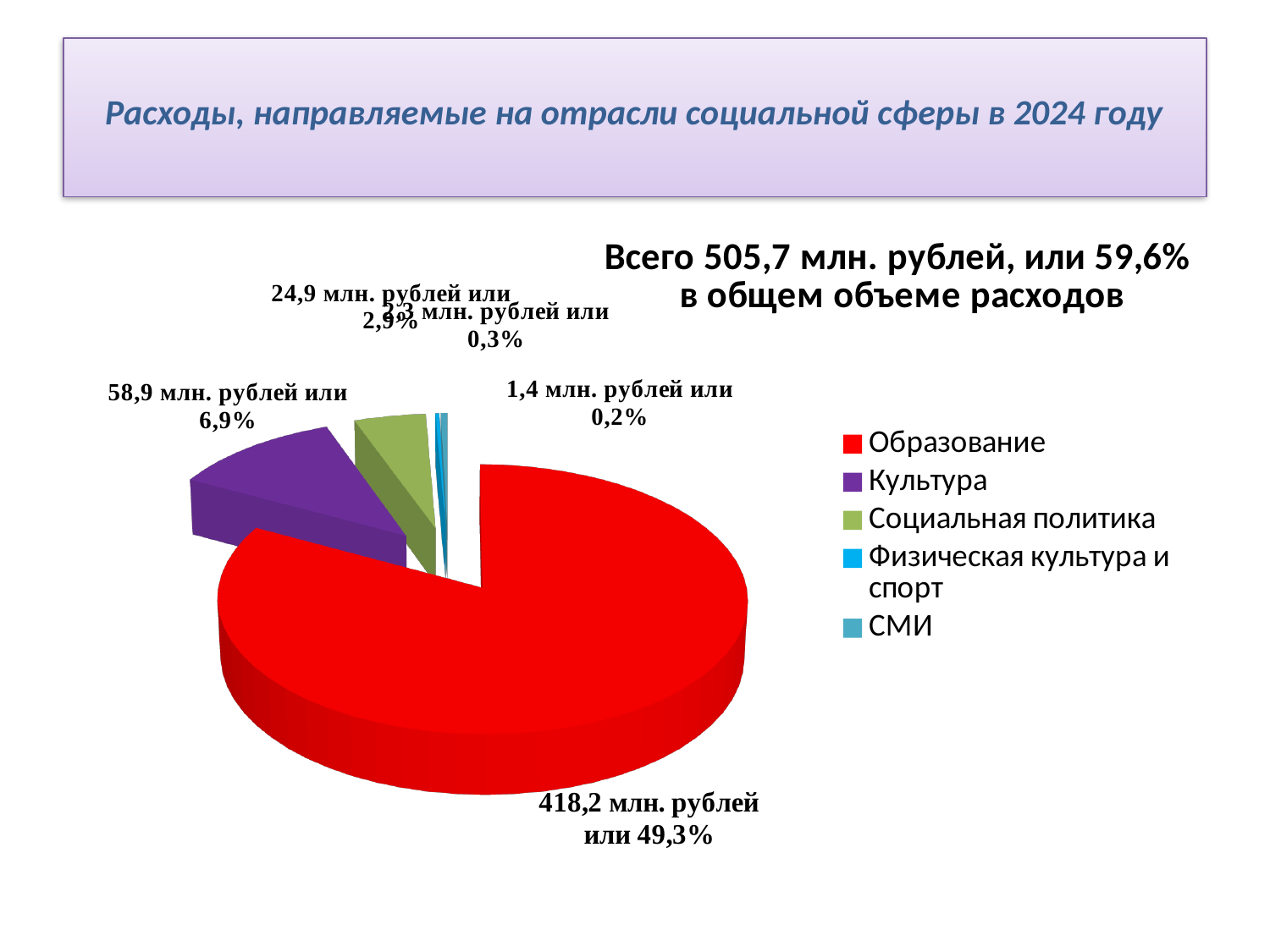
What kind of chart is shown on the slide? Pie chart Which category has the largest slice of the pie? Образование Which is larger, Культура or Социальная политика? Культура What amount is shown for Культура? 58,9 млн. рублей What amount is shown for Образование? 418,2 млн. рублей What total amount is stated on the slide for social sphere expenditures? 505,7 млн. рублей What share of the pie does Образование represent? 49,3% What is the difference between the amounts for Образование and Культура? 359,3 млн. рублей How many slices does the pie chart have? 5 What percentage is shown for Культура? 6,9% What amount is shown for Социальная политика? 24,9 млн. рублей How many entries does the legend list? 5